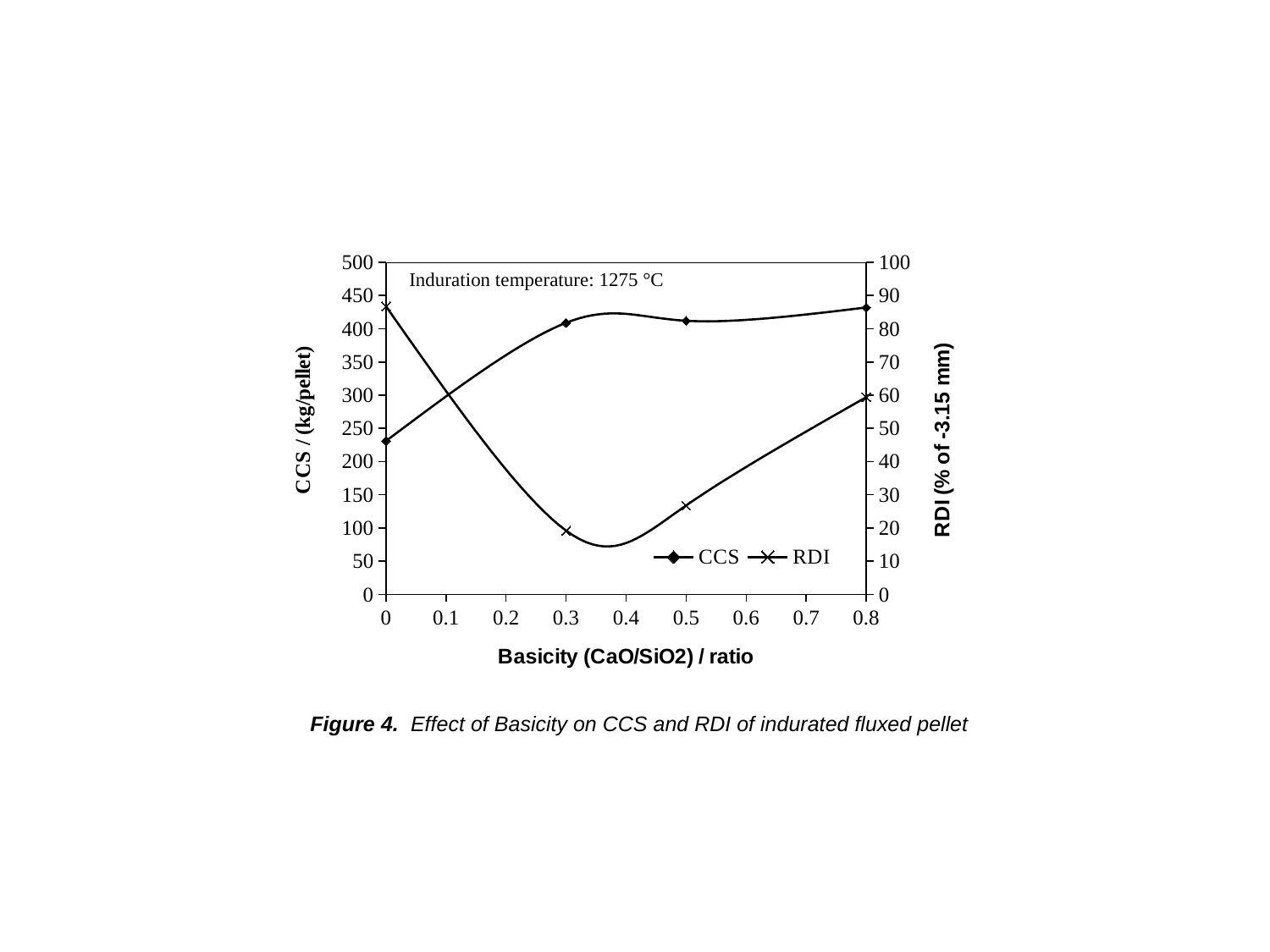
How many series does the legend list? 2 At which basicity value is CCS lowest? 0 Does the RDI value rise or fall as basicity increases from 0 to 0.3? fall Is the RDI value at basicity 0.8 greater or less than 50? greater What induration temperature is noted on the chart? 1275 °C Is the RDI value at basicity 0 greater or less than 80? greater How many data points are plotted for the CCS series? 4 Is the CCS value at basicity 0.3 greater or less than 400? greater At which basicity value is RDI lowest? 0.3 At which basicity value is RDI highest? 0 What kind of chart is shown on the slide? line chart